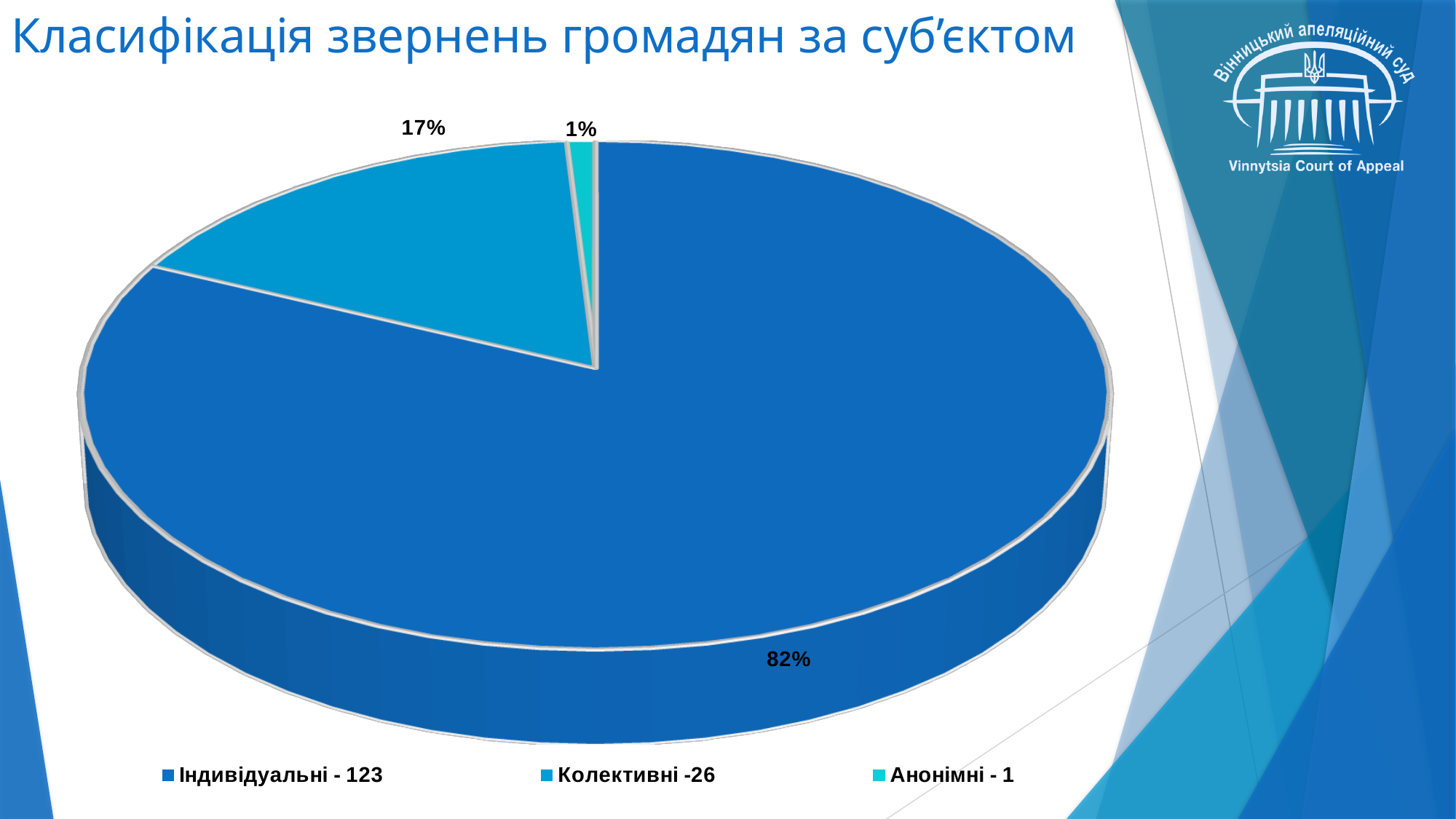
What is the title of the chart on the slide? Класифікація звернень громадян за суб'єктом What is the difference in percentage points between the Індивідуальні and Колективні slices? 65% According to the legend, how many appeals are in the Колективні category? 26 What percentage share does the Анонімні slice have? 1% How many slices does the pie chart have? 3 What percentage share does the Колективні slice have? 17% What kind of chart is shown on the slide? pie chart How many entries does the legend list? 3 What percentage share does the Індивідуальні slice have? 82% Which slice is larger, Колективні or Анонімні? Колективні Which category has the smallest slice of the pie? Анонімні Which category has the largest slice of the pie? Індивідуальні